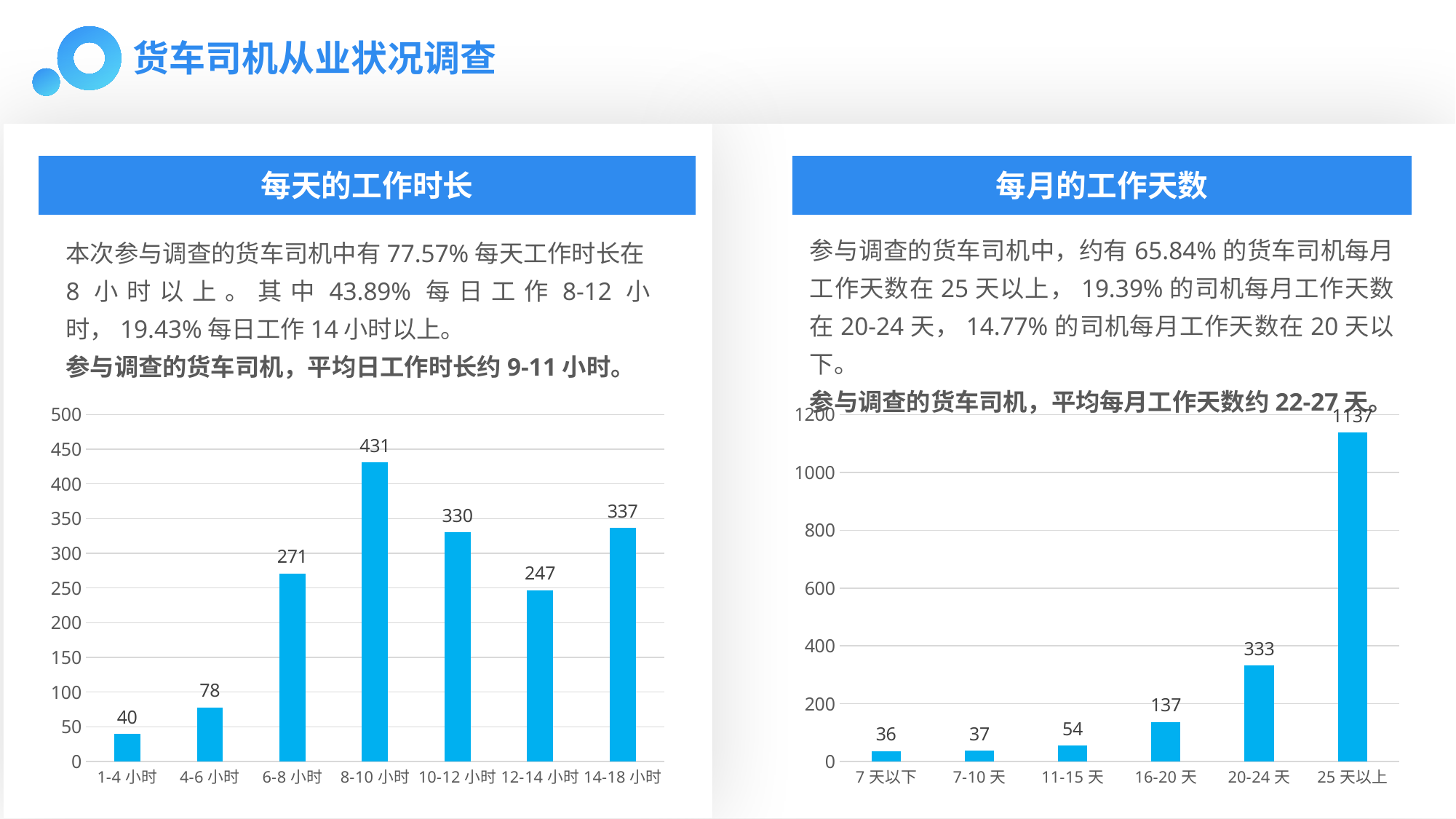
In the chart titled 每月的工作天数, what is the value for 11-15 天? 54 In the chart titled 每天的工作时长, which is larger, the value for 10-12 小时 or the value for 6-8 小时? 10-12 小时 In the chart titled 每天的工作时长, what kind of chart is it? bar chart In the chart titled 每天的工作时长, how many categories are shown on the x axis? 7 In the chart titled 每月的工作天数, what is the value for 25 天以上? 1137 In the chart titled 每天的工作时长, what is the value for 8-10 小时? 431 In the chart titled 每月的工作天数, which category has the highest value? 25 天以上 In the chart titled 每月的工作天数, what is the difference between the values for 20-24 天 and 16-20 天? 196 In the chart titled 每月的工作天数, how many bars are plotted? 6 In the chart titled 每天的工作时长, which category has the lowest value? 1-4 小时 In the chart titled 每月的工作天数, is the value for 20-24 天 greater or less than 400? less In the chart titled 每天的工作时长, what is the difference between the values for 14-18 小时 and 12-14 小时? 90